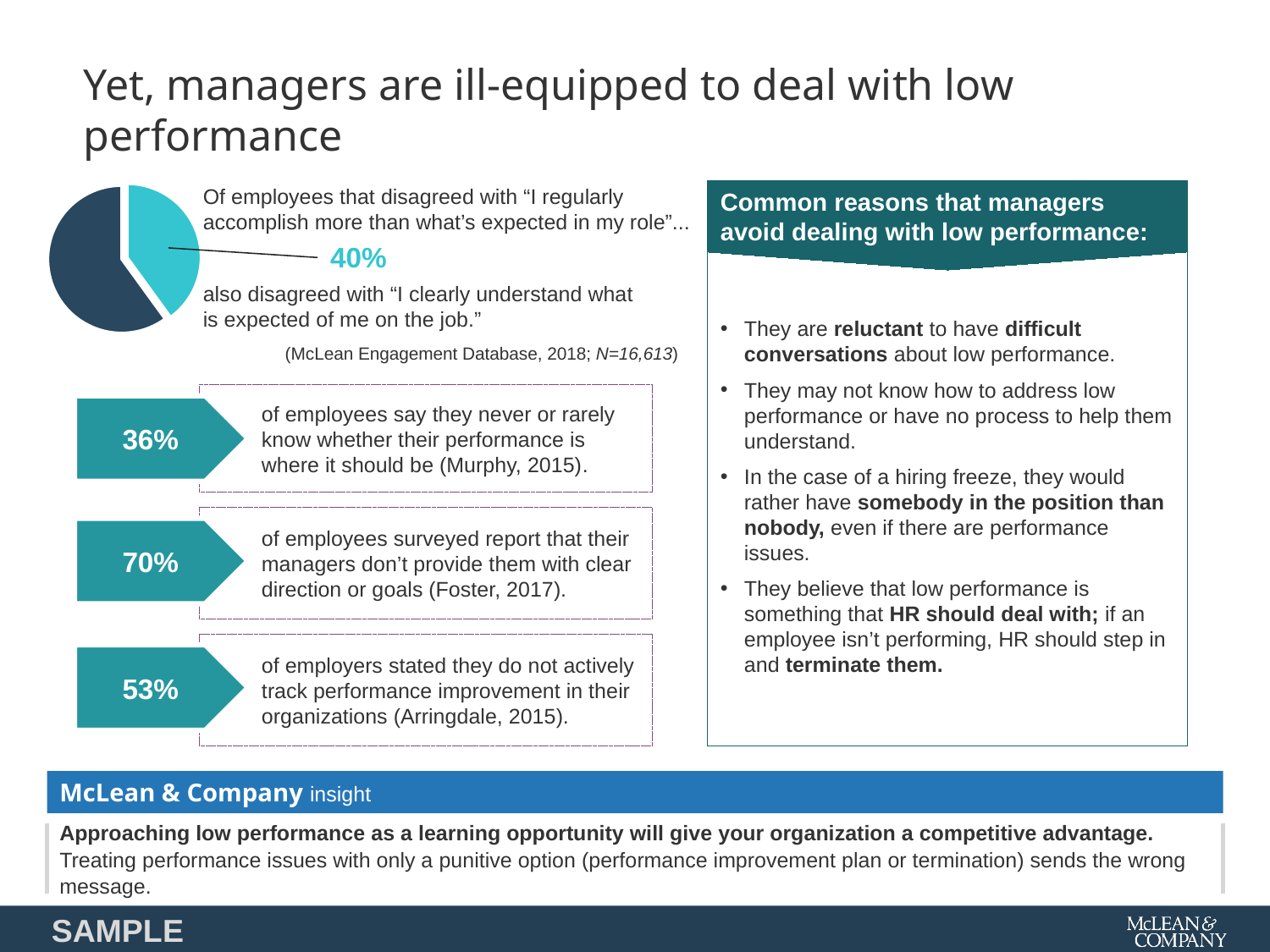
What colour is the slice of the pie chart that is labelled 40%? teal How many slices does the pie chart have? 2 According to the text next to the pie chart, what source and sample size does the 40% figure come from? McLean Engagement Database, 2018; N=16,613 Is the labelled slice of the pie chart greater or less than 50%? less Which slice of the pie chart is the smallest? the teal slice (40%) What percentage is labelled on the teal slice of the pie chart? 40% What kind of chart is shown on the left of the slide? pie chart Which slice of the pie chart is larger, the teal slice or the dark navy slice? the dark navy slice